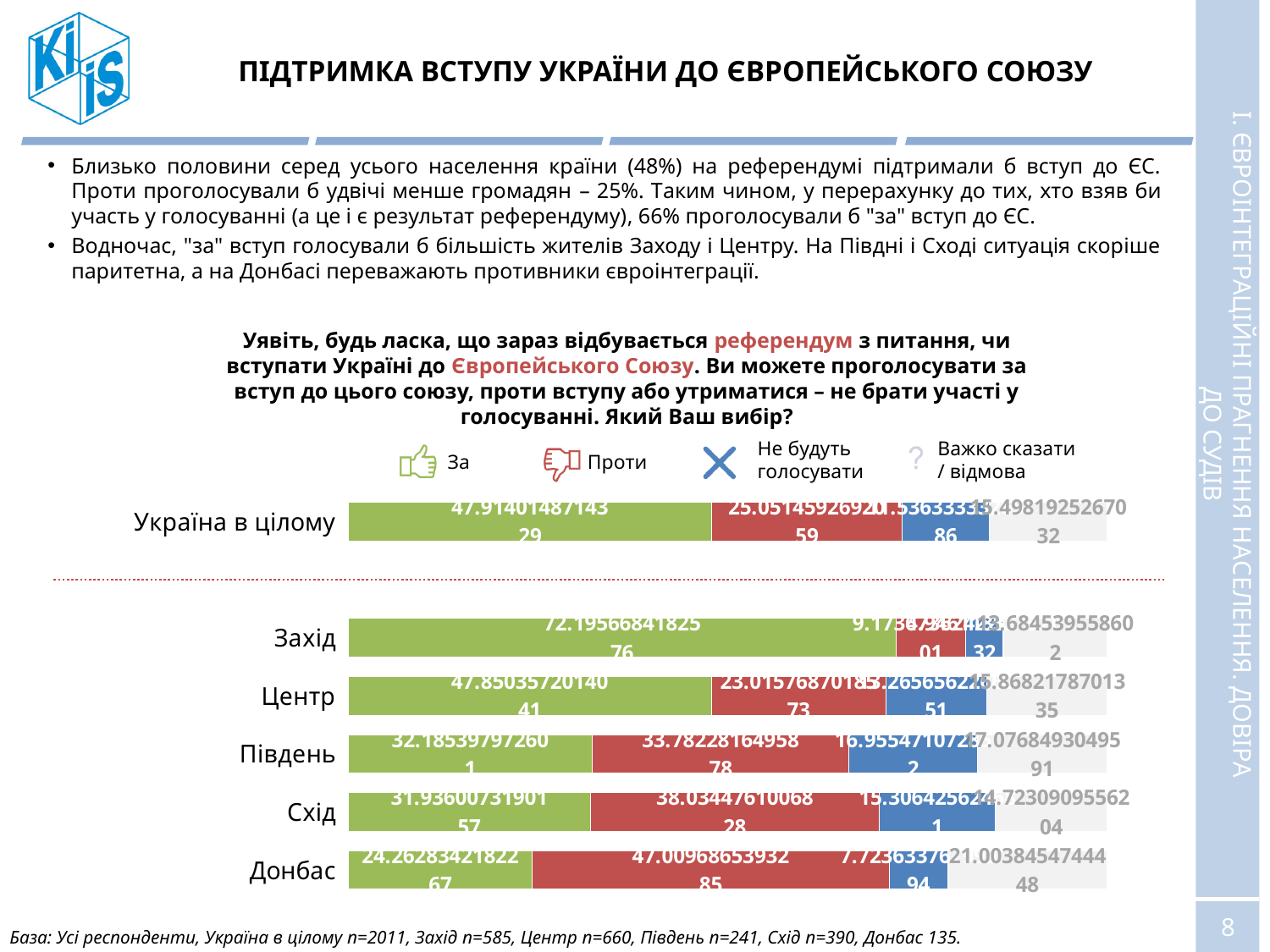
Which region has the largest "За" segment? Захід What colour represents the "Не буду голосувати" series in the chart? Blue How many categories (rows) are plotted in the chart, including Україна в цілому? 6 What colour represents the "За" series in the chart? Green For Донбас, which is larger: the "За" segment or the "Проти" segment? Проти How many regions are plotted below the dotted line separating them from Україна в цілому? 5 Which region has the largest "Проти" segment? Донбас Which region has the smallest "Проти" segment? Захід What kind of chart is shown on the slide? Stacked bar chart Which region has the smallest "За" segment? Донбас How many series does the chart legend list? 4 Which is larger: the "За" segment for Захід or the "За" segment for Центр? Захід